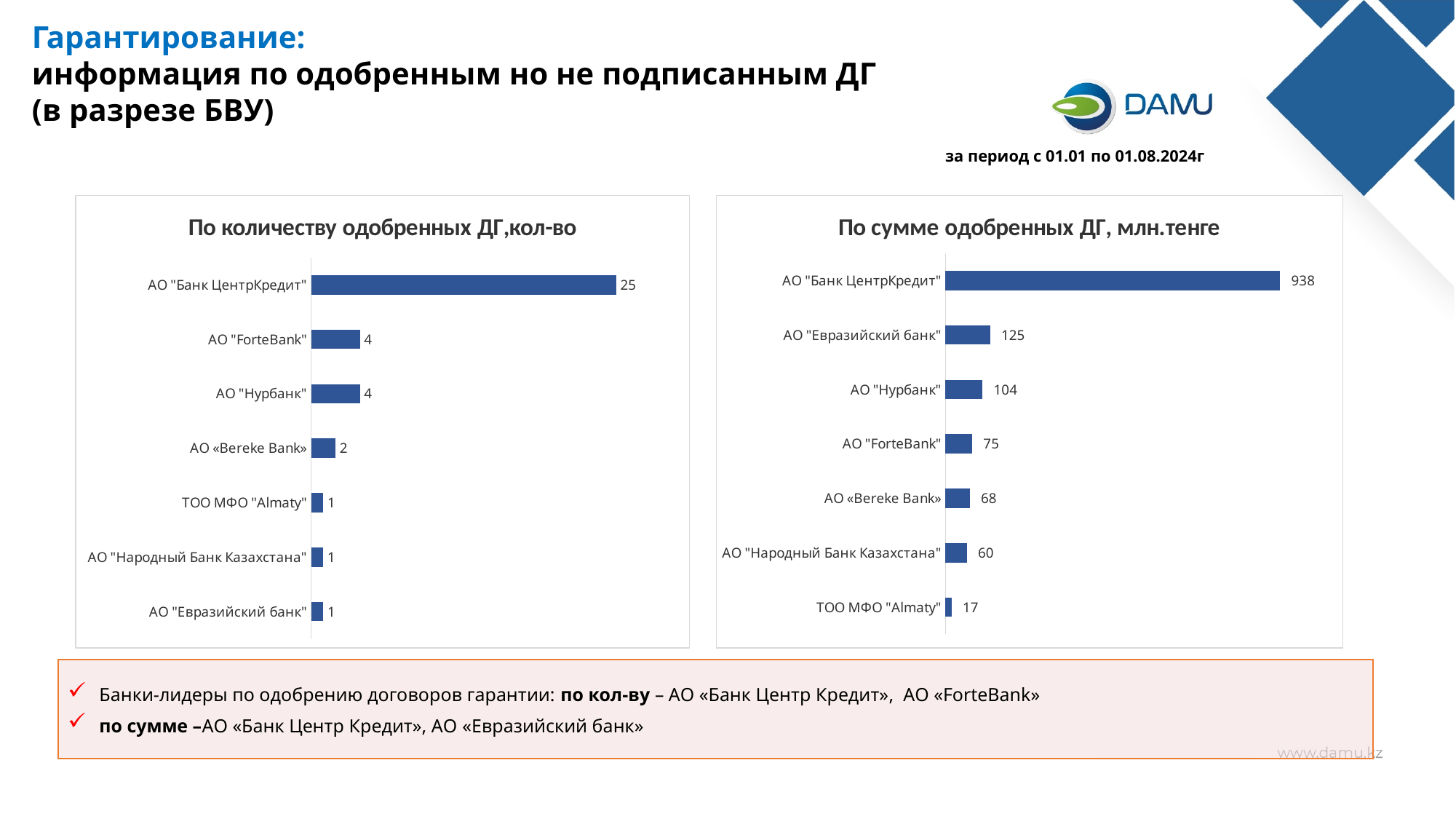
In the chart "По сумме одобренных ДГ, млн.тенге", which category has the lowest value? ТОО МФО "Almaty" What is the title of the chart on the right side of the slide? По сумме одобренных ДГ, млн.тенге How many categories are shown in the chart "По количеству одобренных ДГ,кол-во"? 7 In the chart "По количеству одобренных ДГ,кол-во", which category has the highest value? АО "Банк ЦентрКредит" In the chart "По сумме одобренных ДГ, млн.тенге", what is the value for АО "Евразийский банк"? 125 In the chart "По сумме одобренных ДГ, млн.тенге", what is the value for ТОО МФО "Almaty"? 17 In the chart "По количеству одобренных ДГ,кол-во", what is the value for АО "Банк ЦентрКредит"? 25 In the chart "По сумме одобренных ДГ, млн.тенге", which is larger: АО "Нурбанк" or АО "ForteBank"? АО "Нурбанк" In the chart "По количеству одобренных ДГ,кол-во", what is the difference between АО "Банк ЦентрКредит" and АО "ForteBank"? 21 What type of chart is "По сумме одобренных ДГ, млн.тенге"? Bar chart In the chart "По сумме одобренных ДГ, млн.тенге", what is the difference between АО "Банк ЦентрКредит" and АО "Евразийский банк"? 813 In the chart "По количеству одобренных ДГ,кол-во", what is the value for АО «Bereke Bank»? 2